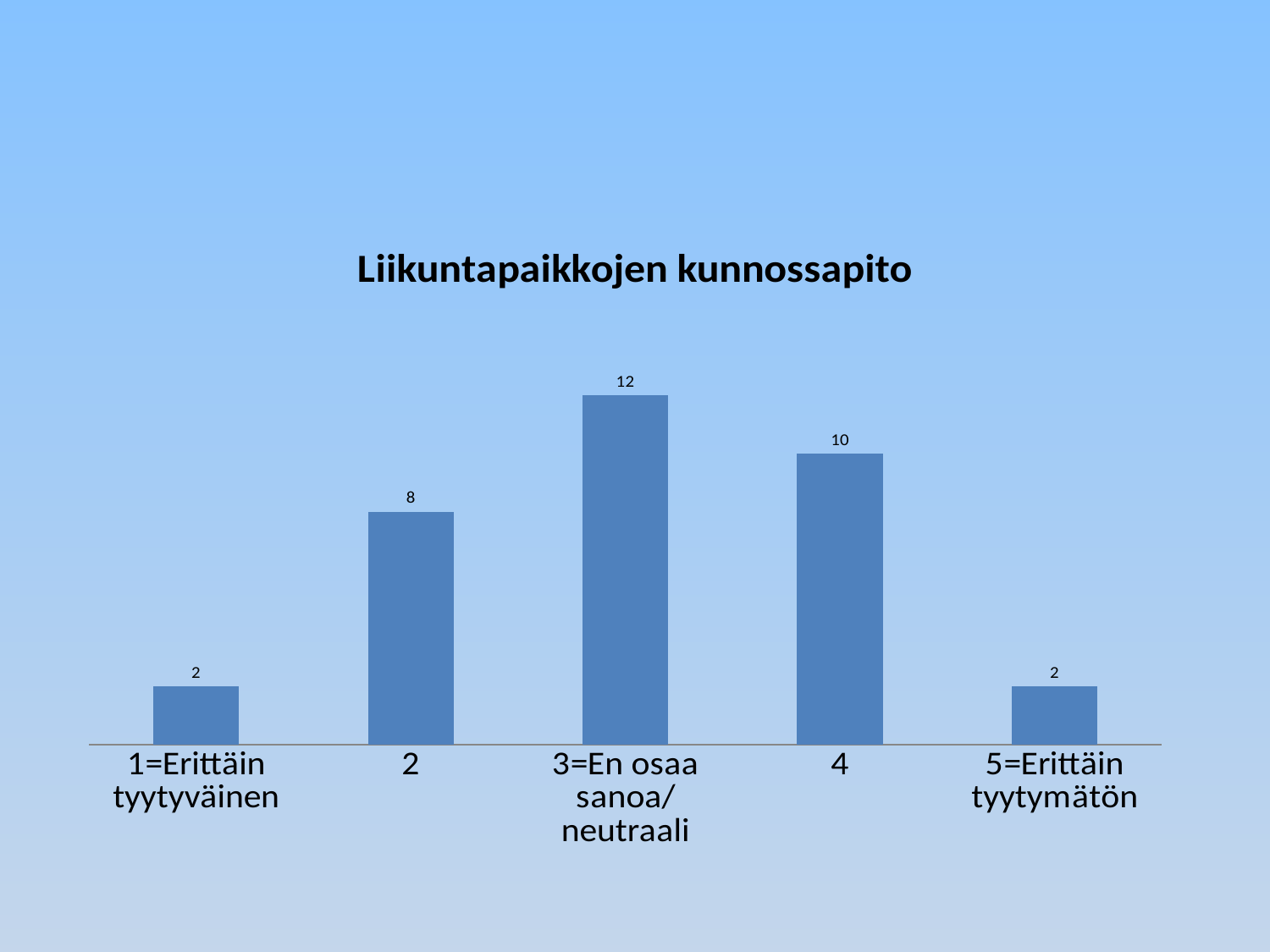
What is the difference between the values for "2" and "1=Erittäin tyytyväinen"? 6 What is the title of the chart? Liikuntapaikkojen kunnossapito How many categories are shown on the x axis? 5 What is the value for "3=En osaa sanoa/ neutraali"? 12 What is the difference between the values for "3=En osaa sanoa/ neutraali" and "4"? 2 What is the value for the category "2"? 8 Which is larger, the value for "2" or the value for "4"? 4 What kind of chart is shown on the slide? Bar chart What is the value for the category "4"? 10 Do the values for "1=Erittäin tyytyväinen" and "5=Erittäin tyytymätön" differ? No, both are 2 Which category has the highest value? 3=En osaa sanoa/ neutraali What is the value for "1=Erittäin tyytyväinen"? 2